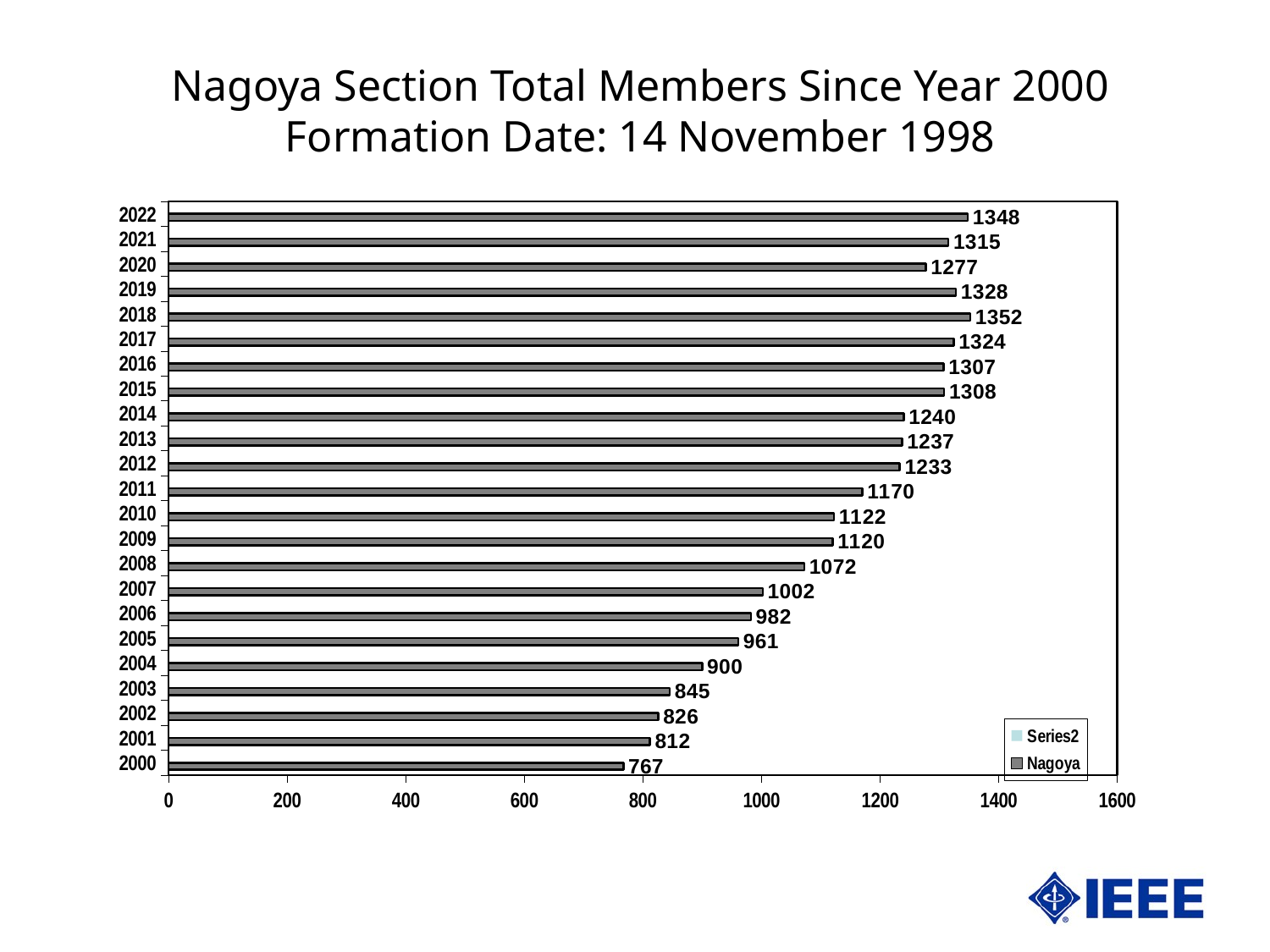
How many series does the legend list? 2 What is the value for 2022? 1348 What is the value for 2010? 1122 Is the value for 2007 greater or less than 1000? greater Which year has the highest value? 2018 How many years are shown on the chart? 23 Which is larger, the value for 2019 or the value for 2020? 2019 What is the value for 2000? 767 What is the difference between the values for 2022 and 2000? 581 What kind of chart is shown? bar chart Which year has the lowest value? 2000 What is the title of the chart? Nagoya Section Total Members Since Year 2000 Formation Date: 14 November 1998